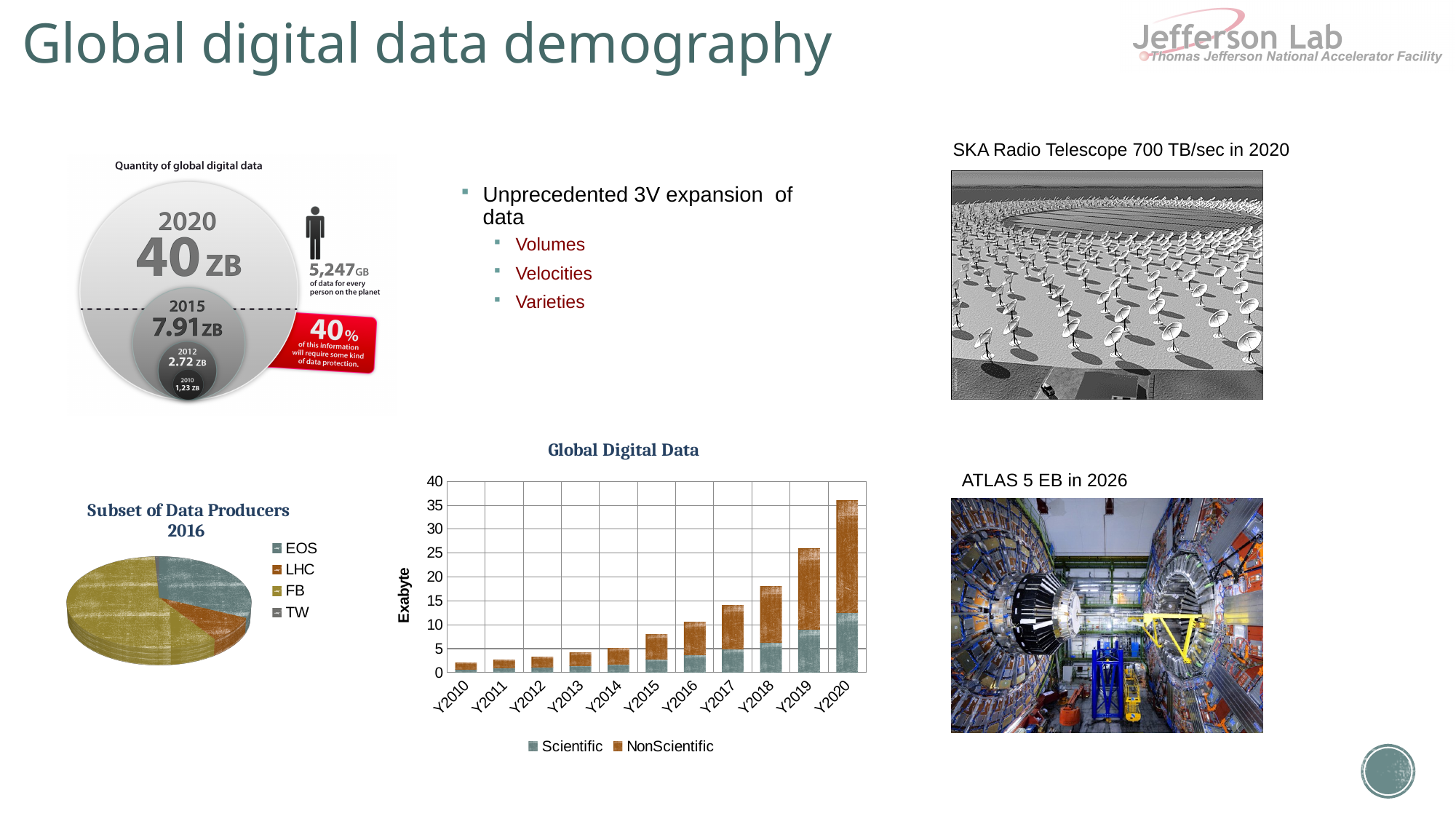
In the 'Subset of Data Producers 2016' chart, which category has the largest slice? FB In the 'Global Digital Data' chart, which year has the highest total? Y2020 In the 'Global Digital Data' chart, is the total for Y2020 greater or less than 30? greater How many categories does the legend of the 'Subset of Data Producers 2016' chart list? 4 How many series does the legend of the 'Global Digital Data' chart list? 2 How many years are shown on the x axis of the 'Global Digital Data' chart? 11 What kind of chart is the 'Global Digital Data' chart? Stacked bar chart In the 'Global Digital Data' chart, do the totals rise or fall from Y2010 to Y2020? Rise In the 'Global Digital Data' chart, which is larger for Y2020, Scientific or NonScientific? NonScientific In the 'Global Digital Data' chart, is the total for Y2010 greater or less than 5? less In the 'Global Digital Data' chart, which year has the lowest total? Y2010 What kind of chart is the 'Subset of Data Producers 2016' chart? Pie chart